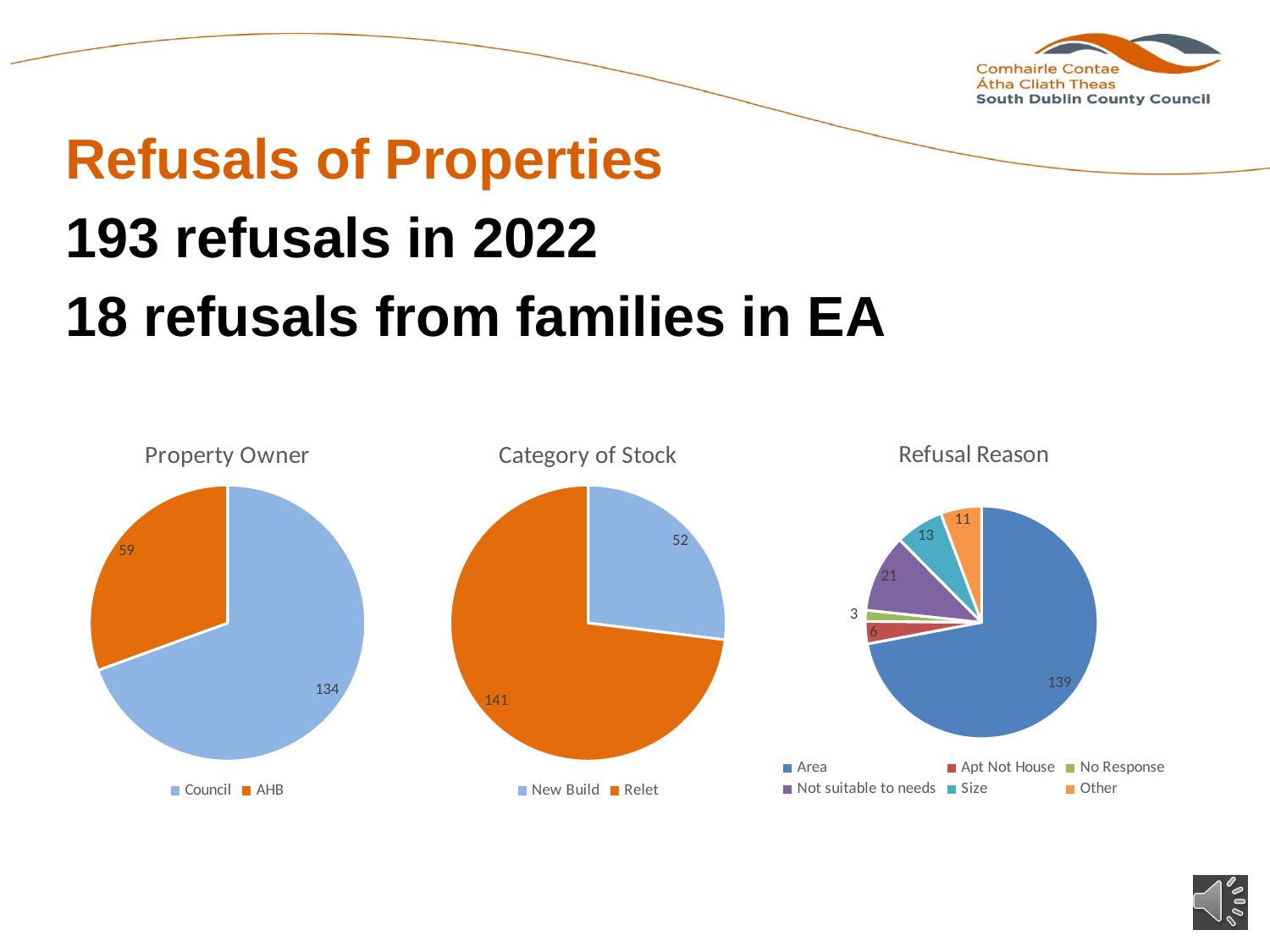
In the Refusal Reason chart, which is larger, Size or Other? Size In the Property Owner chart, what is the value for Council? 134 In the Refusal Reason chart, how many refusal reasons are listed in the legend? 6 In the Category of Stock chart, what is the value for Relet? 141 In the Refusal Reason chart, what is the value for Area? 139 In the Category of Stock chart, what is the difference between the Relet and New Build values? 89 In the Category of Stock chart, which category is larger, New Build or Relet? Relet In the Property Owner chart, what is the value for AHB? 59 In the Refusal Reason chart, which reason has the lowest value? No Response What kind of chart is the Refusal Reason chart? Pie chart In the Refusal Reason chart, what is the value for Not suitable to needs? 21 In the Property Owner chart, what is the difference between the Council and AHB values? 75